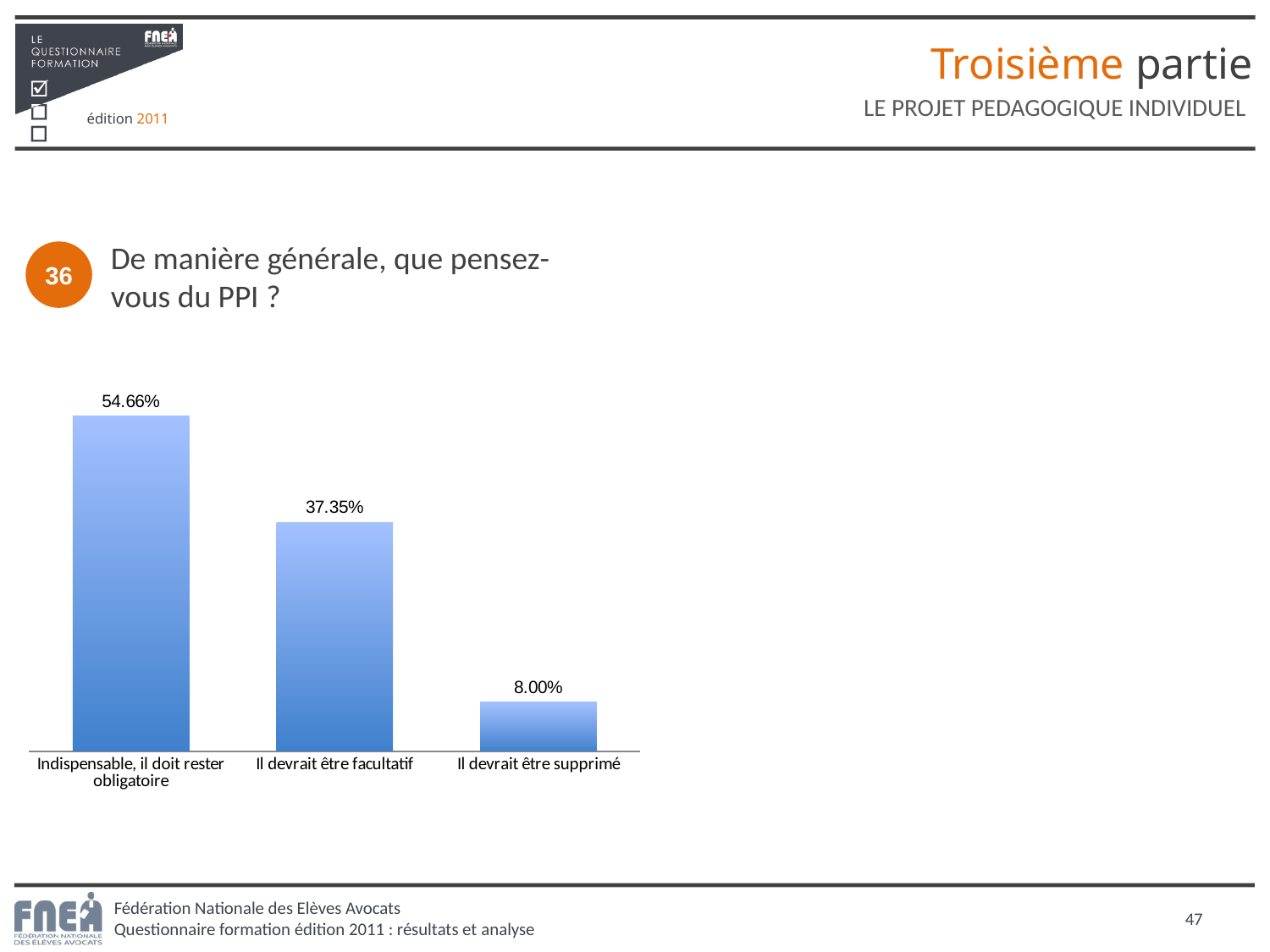
Do the values rise or fall from left to right across the categories? Fall Which is larger: the value for "Il devrait être facultatif" or the value for "Il devrait être supprimé"? Il devrait être facultatif How many response categories are shown in the chart? 3 What is the value shown for "Il devrait être facultatif"? 37.35% What is the difference between the values for "Il devrait être facultatif" and "Il devrait être supprimé"? 29.35% Which response category has the lowest value? Il devrait être supprimé Which response category has the highest value? Indispensable, il doit rester obligatoire What is the value shown for "Il devrait être supprimé"? 8.00% What is the difference between the values for "Indispensable, il doit rester obligatoire" and "Il devrait être facultatif"? 17.31% What percentage of respondents answered "Indispensable, il doit rester obligatoire"? 54.66% What is the number of the survey question shown on the slide? 36 What type of chart is shown on the slide? Bar chart